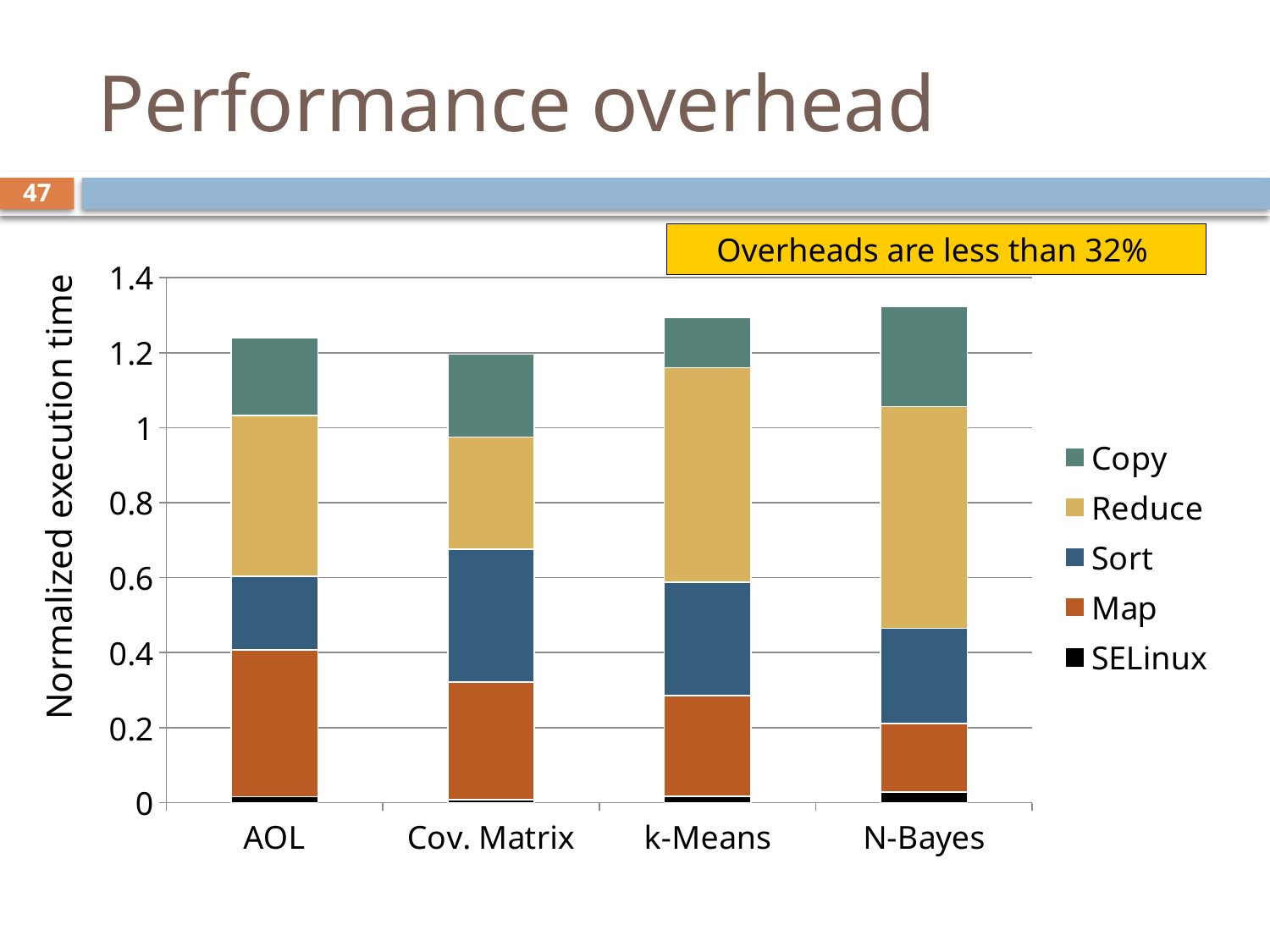
Is the total normalized execution time for k-Means greater or less than 1.2? greater Which workload has the shortest stacked bar (lowest normalized execution time)? Cov. Matrix Which workload has the tallest stacked bar (highest normalized execution time)? N-Bayes What kind of chart is shown on the slide? Stacked bar chart What is the label on the y axis? Normalized execution time Which workload has the larger Sort segment, AOL or Cov. Matrix? Cov. Matrix Is the Map segment for Cov. Matrix greater or less than 0.4? less What does the yellow callout box above the chart say? Overheads are less than 32% Which workload has the larger Map segment, AOL or N-Bayes? AOL How many categories (workloads) are shown on the x axis? 4 How many series does the legend list? 5 Is the total normalized execution time for AOL greater or less than 1.2? greater